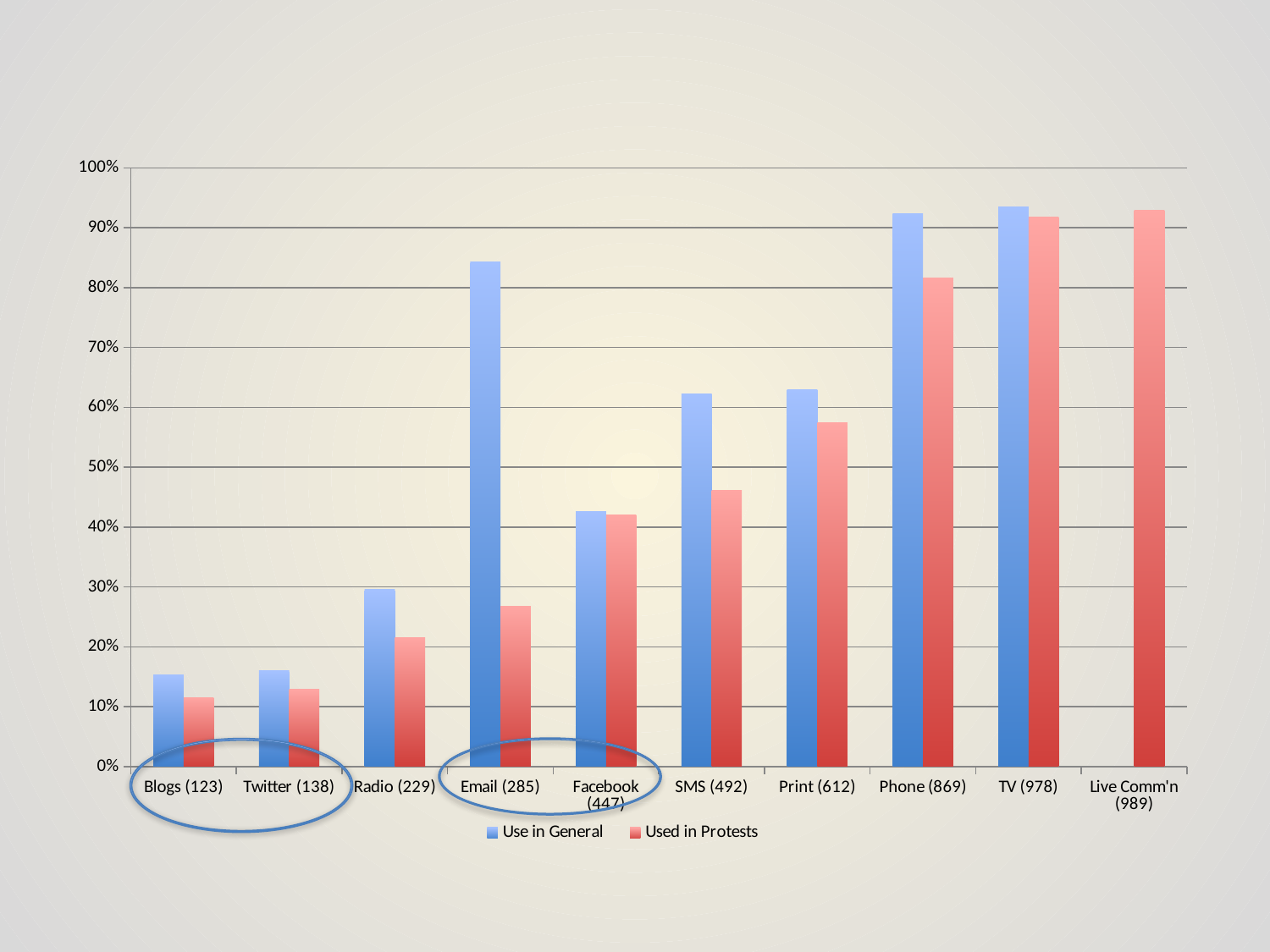
Is the Use in General value for Email (285) greater or less than 80%? greater What are the two legend entries? Use in General, Used in Protests Is the Used in Protests value for Email (285) greater or less than 30%? less What kind of chart is shown on the slide? bar chart Which has the larger Used in Protests value, Phone (869) or TV (978)? TV (978) Is the Use in General value for Phone (869) greater or less than 90%? greater For Email (285), which series has the larger value, Use in General or Used in Protests? Use in General Which category has no Use in General bar? Live Comm'n (989) How many series does the legend list? 2 How many categories are shown on the x axis? 10